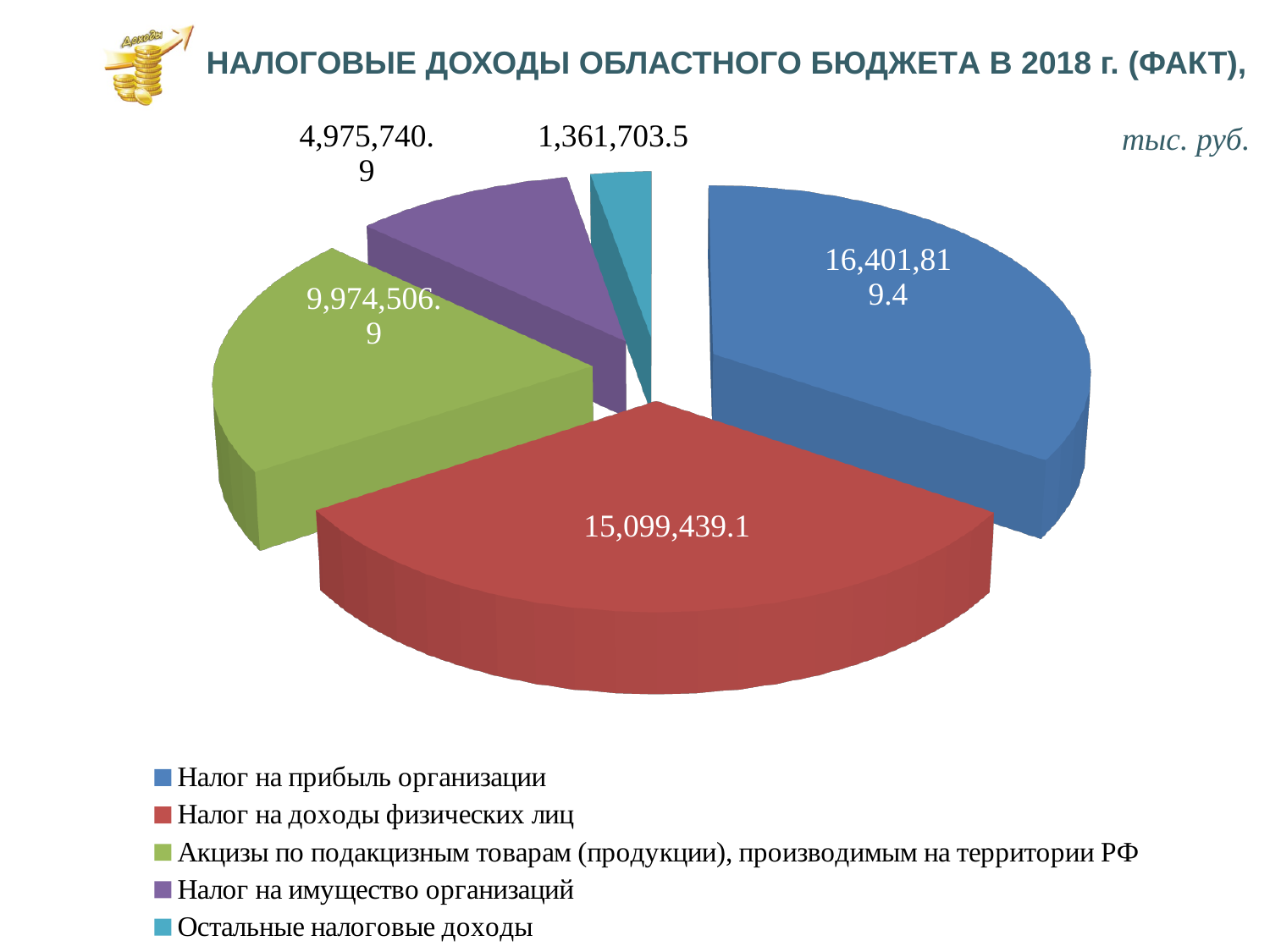
What is the difference between Налог на прибыль организации and Налог на доходы физических лиц? 1,302,380.3 What is the value for Налог на доходы физических лиц? 15,099,439.1 What is the value for Остальные налоговые доходы? 1,361,703.5 What is the value for Налог на имущество организаций? 4,975,740.9 How many entries does the legend list? 5 Which category has the largest value? Налог на прибыль организации What type of chart is shown on the slide? pie chart What is the value for Налог на прибыль организации? 16,401,819.4 How many slices does the pie chart have? 5 Which is larger: Акцизы по подакцизным товарам (продукции), производимым на территории РФ or Налог на имущество организаций? Акцизы по подакцизным товарам (продукции), производимым на территории РФ What is the value for Акцизы по подакцизным товарам (продукции), производимым на территории РФ? 9,974,506.9 Which category has the smallest value? Остальные налоговые доходы